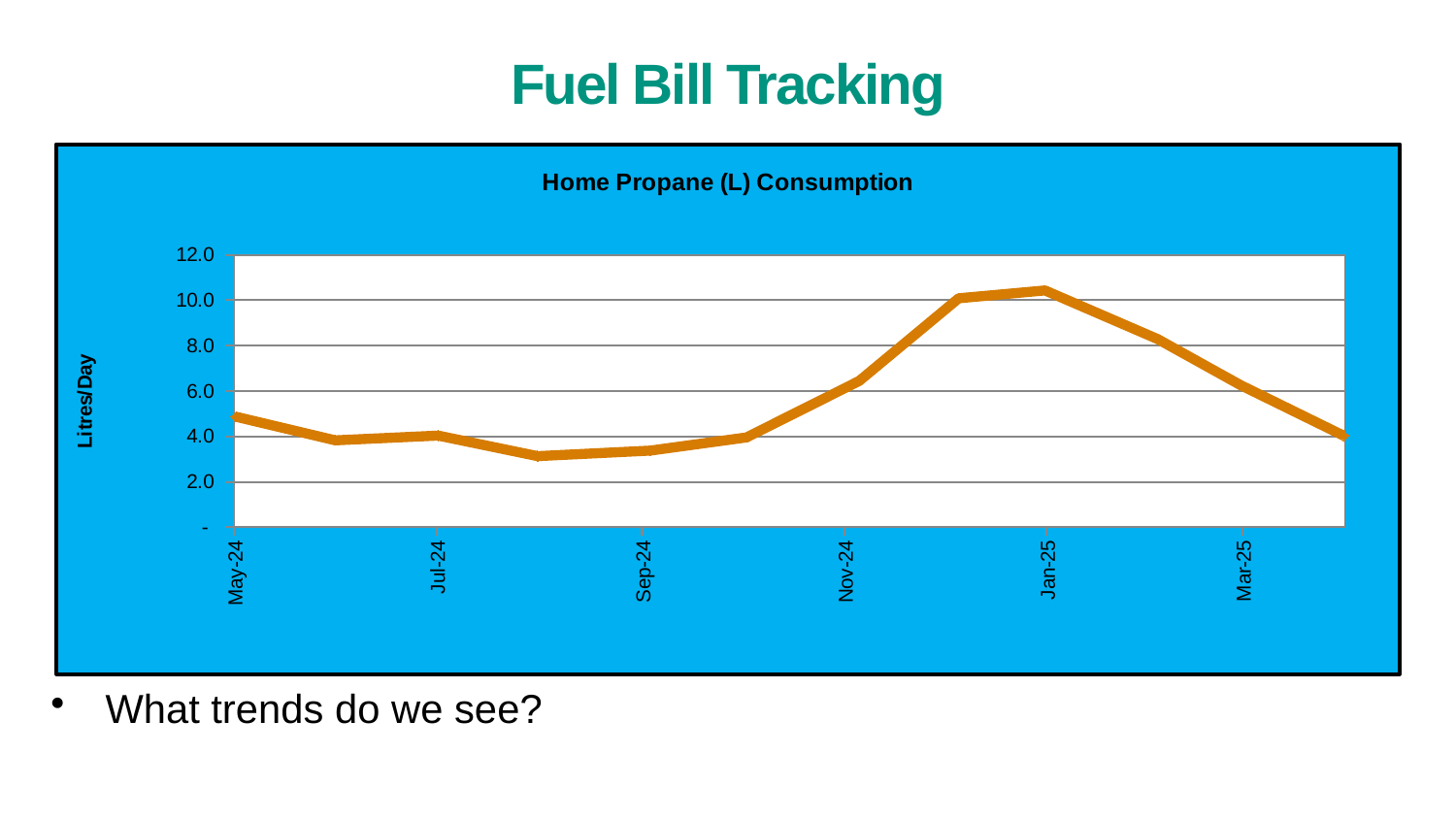
Which has the higher value, Jan-25 or Jul-24? Jan-25 Which has the higher value, Nov-24 or Sep-24? Nov-24 Is the value for May-24 greater or less than 6.0? less Does the line rise or fall between Jan-25 and Mar-25? fall Does the line rise or fall between Sep-24 and Jan-25? rise How many month labels are shown on the x axis of the chart? 6 Is the value for Jan-25 greater or less than 8.0? greater Is the value for Mar-25 greater or less than 4.0? greater What is the label on the vertical axis of the chart? Litres/Day What kind of chart is shown on the slide? line chart What is the title of the chart? Home Propane (L) Consumption